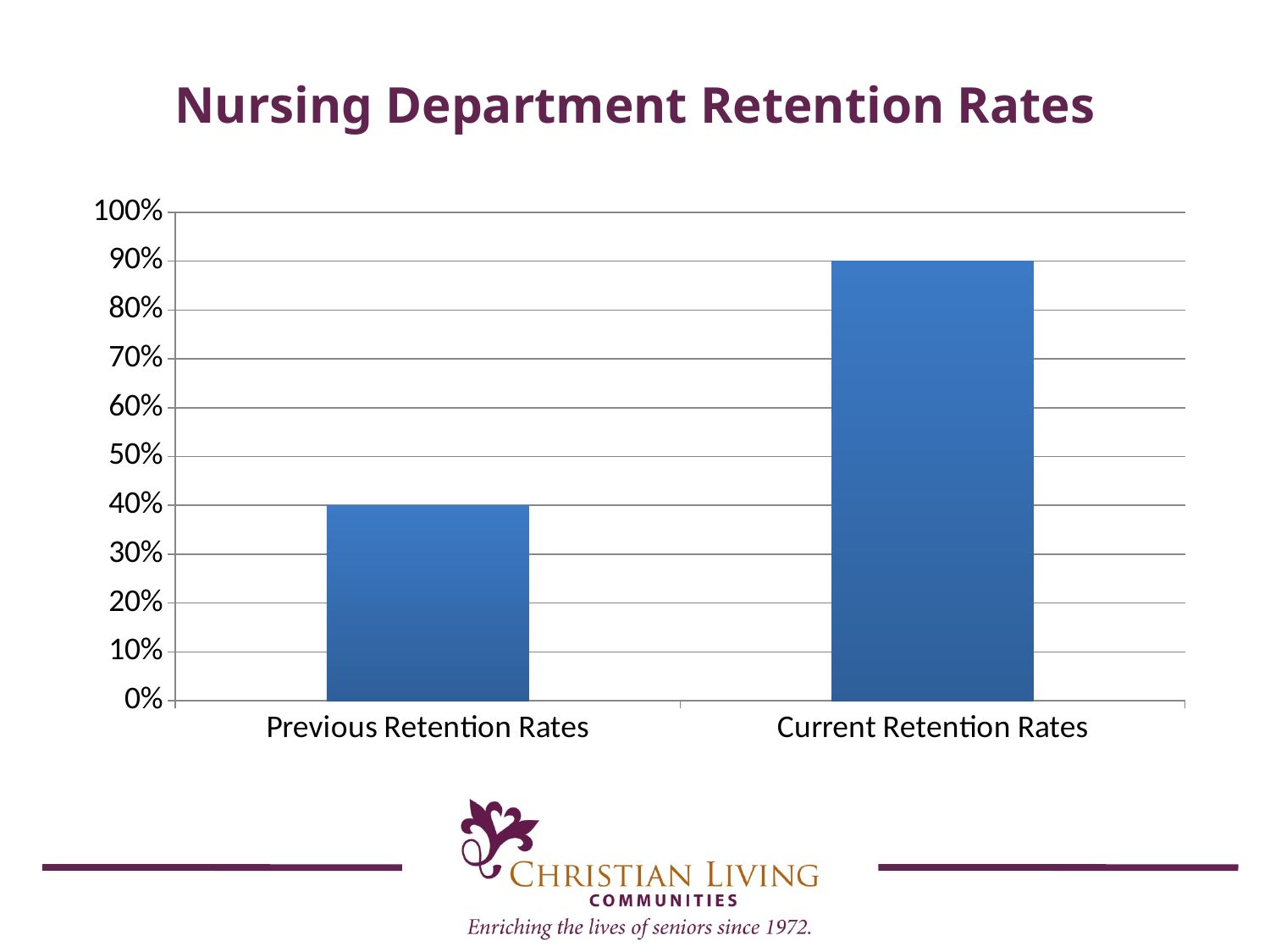
What is the difference between the Current Retention Rates and the Previous Retention Rates? 50% Which category has the highest retention rate? Current Retention Rates Is the value for Current Retention Rates greater or less than 80%? greater Is the value for Previous Retention Rates greater or less than 50%? less What kind of chart is shown on the slide? Bar chart What is the value for Current Retention Rates? 90% Which category has the lowest retention rate? Previous Retention Rates Which is larger, Previous Retention Rates or Current Retention Rates? Current Retention Rates What is the value for Previous Retention Rates? 40% How many categories are shown on the chart? 2 What is the maximum value shown on the vertical axis? 100% What is the title of the chart? Nursing Department Retention Rates